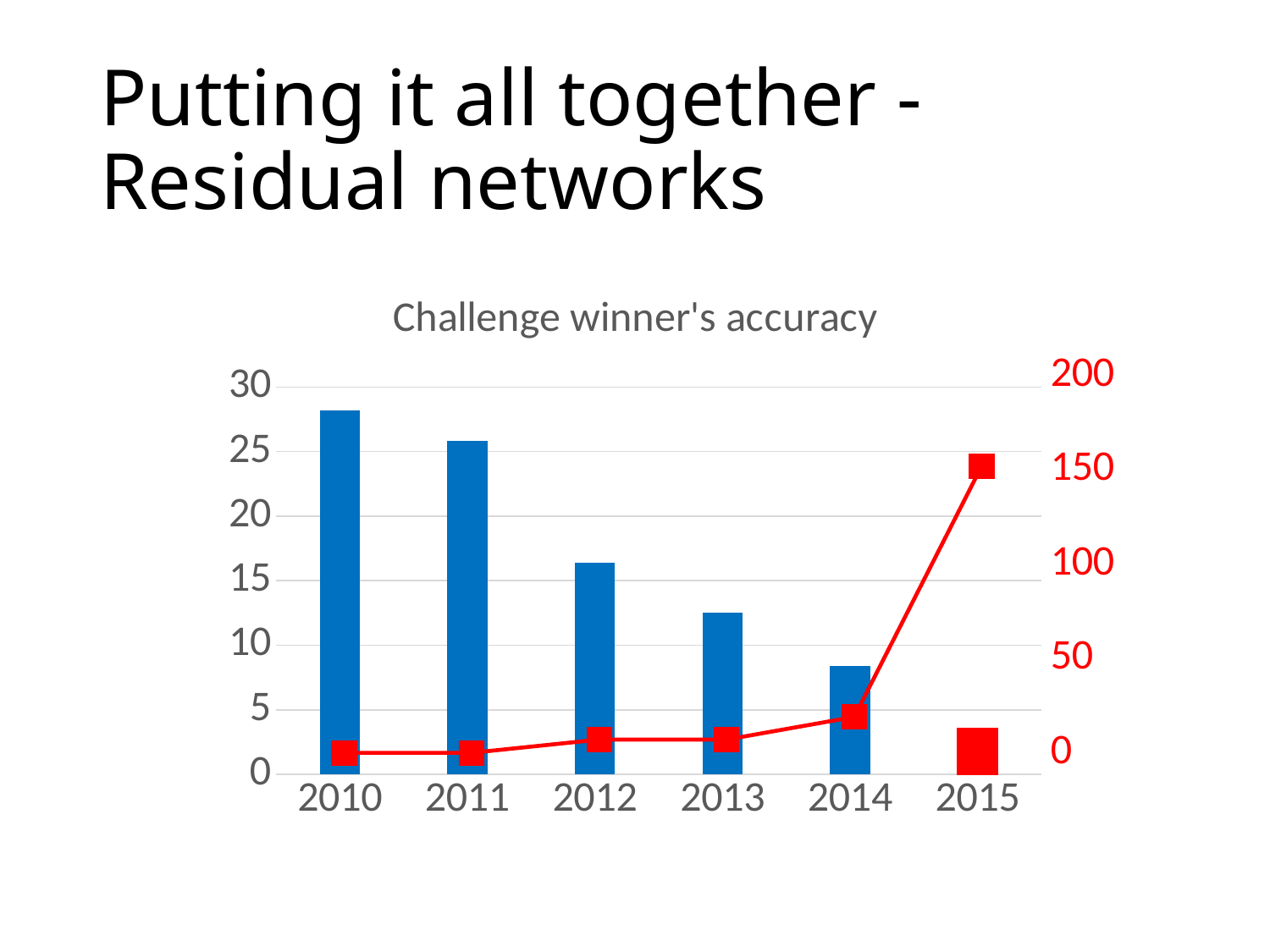
What kind of chart is shown on the slide? A bar chart combined with a line chart Do the bar values rise or fall from 2010 to 2015? fall Is the bar value for 2013 greater or less than 15 on the left axis? less Which bar is taller, 2011 or 2012? 2011 Is the red line value for 2015 greater or less than 100 on the right axis? greater Which year has the highest value on the red line (right axis)? 2015 Is the bar value for 2014 greater or less than 10 on the left axis? less What is the title of the chart? Challenge winner's accuracy Which year has the tallest bar in the chart? 2010 How many years are shown on the x axis of the chart? 6